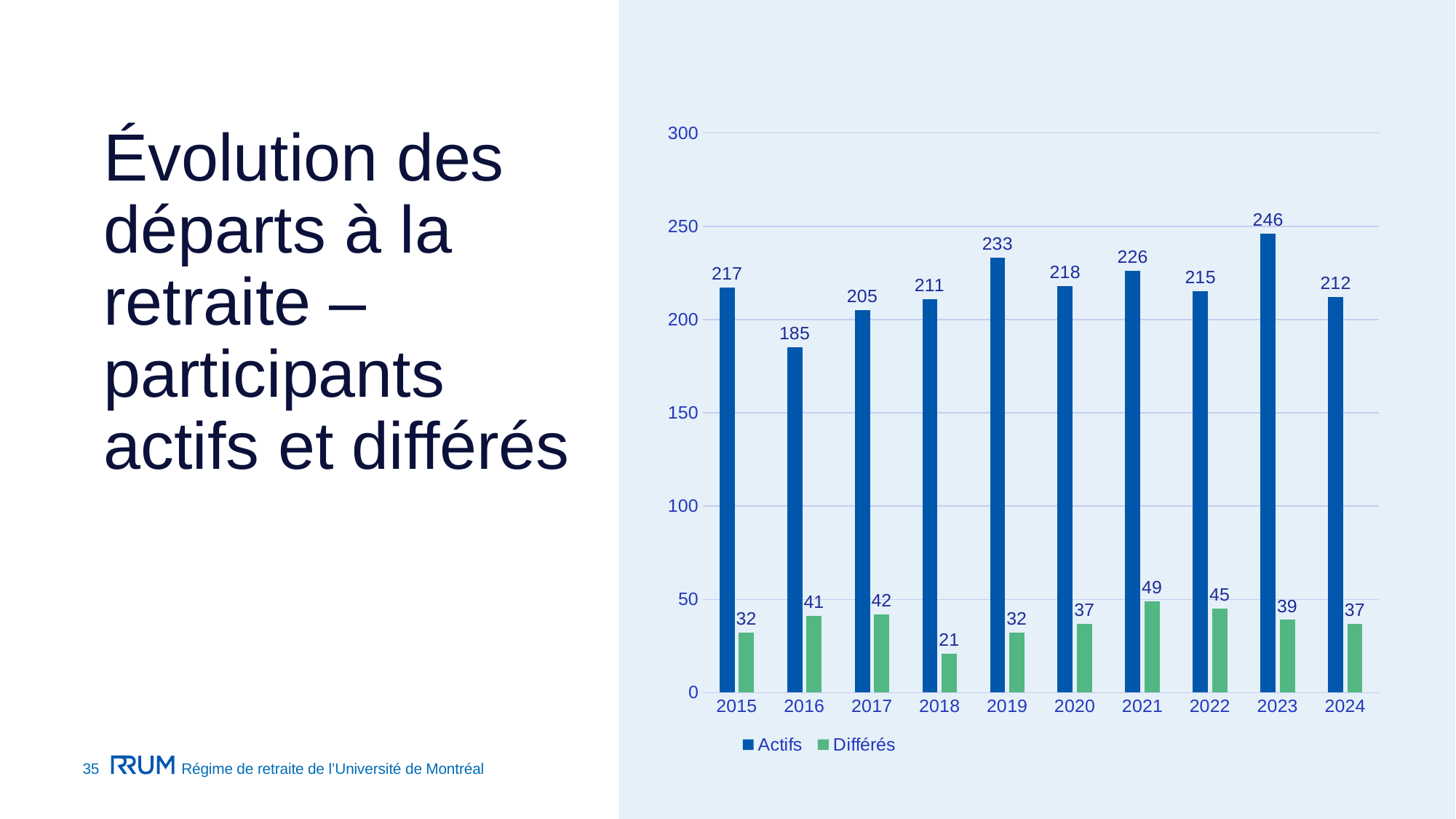
What is the difference between the Actifs values for 2023 and 2016? 61 What colour are the Différés bars? green Is the value for Actifs in 2016 greater or less than 200? less Which is larger, the Différés value for 2021 or for 2022? 2021 What kind of chart is shown on the slide? bar chart What is the value for Actifs in 2019? 233 How many years are shown on the x axis? 10 How many series does the legend list? 2 Which year has the highest value for Actifs? 2023 Which year has the lowest value for Différés? 2018 Which year has the lowest value for Actifs? 2016 What is the value for Différés in 2018? 21